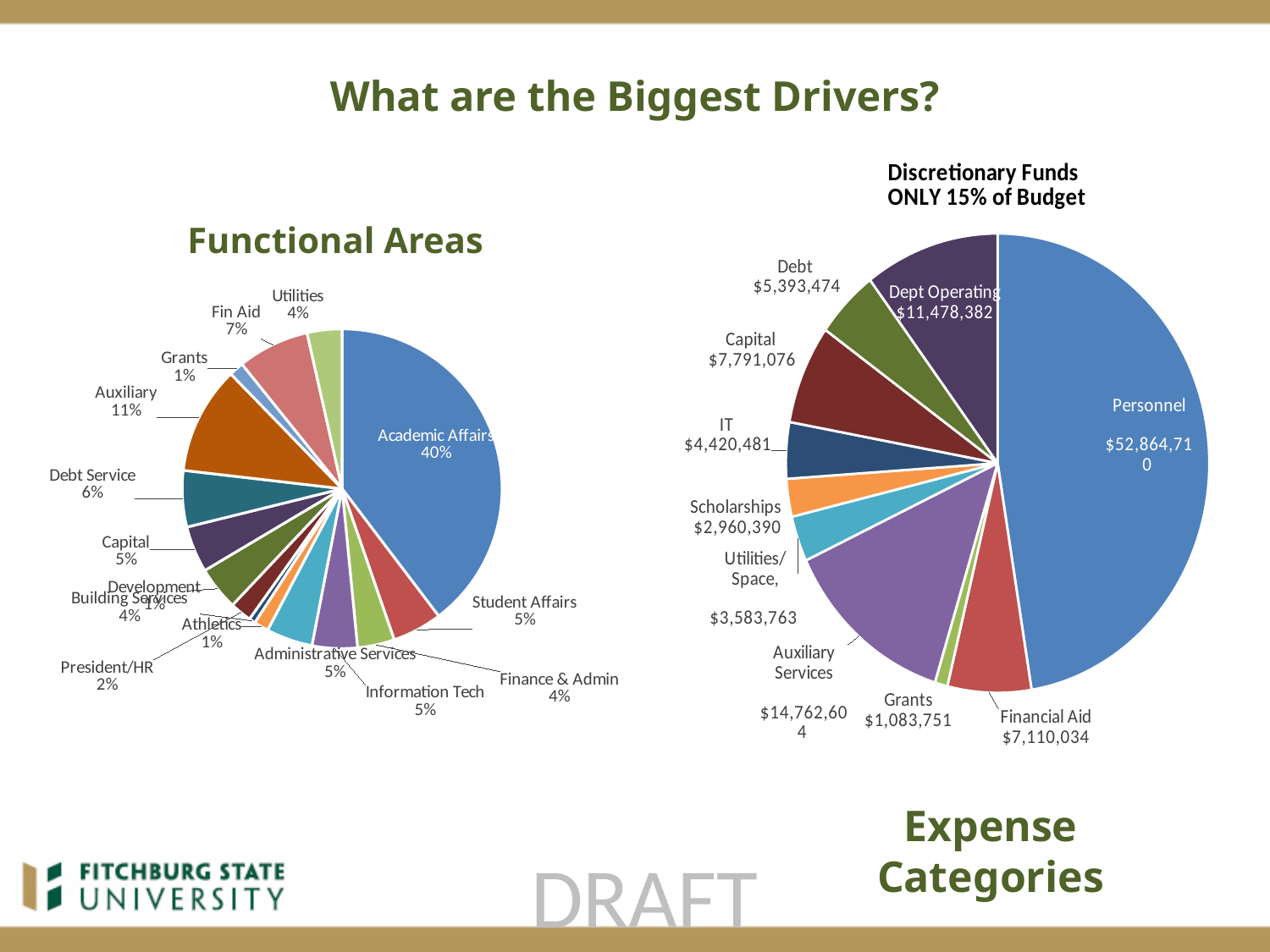
In the Functional Areas chart, which is larger, Capital or President/HR? Capital In the Expense Categories chart, which category has the smallest value? Grants In the Functional Areas chart, what share does Academic Affairs have? 40% In the Functional Areas chart, which functional area has the largest share? Academic Affairs In the Expense Categories chart, which is larger, Capital or Financial Aid? Capital In the Functional Areas chart, what share does Auxiliary have? 11% In the Expense Categories chart, what is the value for Personnel? $52,864,710 In the Expense Categories chart, what is the value for Auxiliary Services? $14,762,604 What type of chart is the Expense Categories chart? Pie chart How many categories are shown in the Expense Categories pie chart? 10 In the Functional Areas chart, what is the difference in percentage points between Fin Aid and Debt Service? 1% How many categories are shown in the Functional Areas pie chart? 15